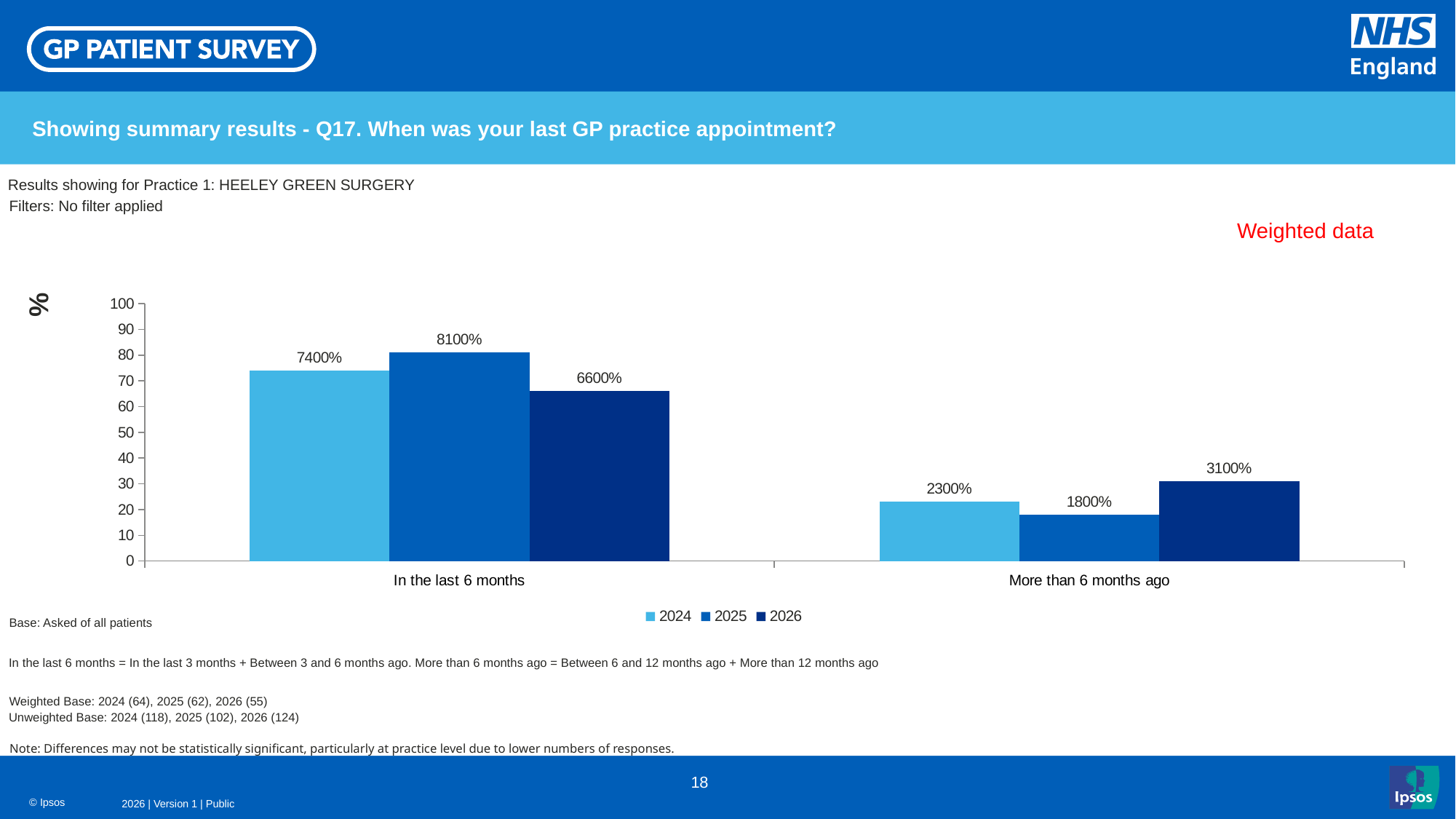
Which is larger in the 'More than 6 months ago' category: the value for 2024 or the value for 2026? 2026 How many series does the legend list? 3 What is the value for 2026 in the 'In the last 6 months' category? 6600% What kind of chart is shown on the slide? Bar chart What is the difference between the 2025 and 2024 values in the 'In the last 6 months' category? 700% What is the value for 2025 in the 'More than 6 months ago' category? 1800% Which practice are the results shown for? HEELEY GREEN SURGERY How many categories are shown on the x axis? 2 Which year has the lowest value in the 'More than 6 months ago' category? 2025 Which year has the highest value in the 'In the last 6 months' category? 2025 What is the value for 2024 in the 'More than 6 months ago' category? 2300% What is the value for 2025 in the 'In the last 6 months' category? 8100%